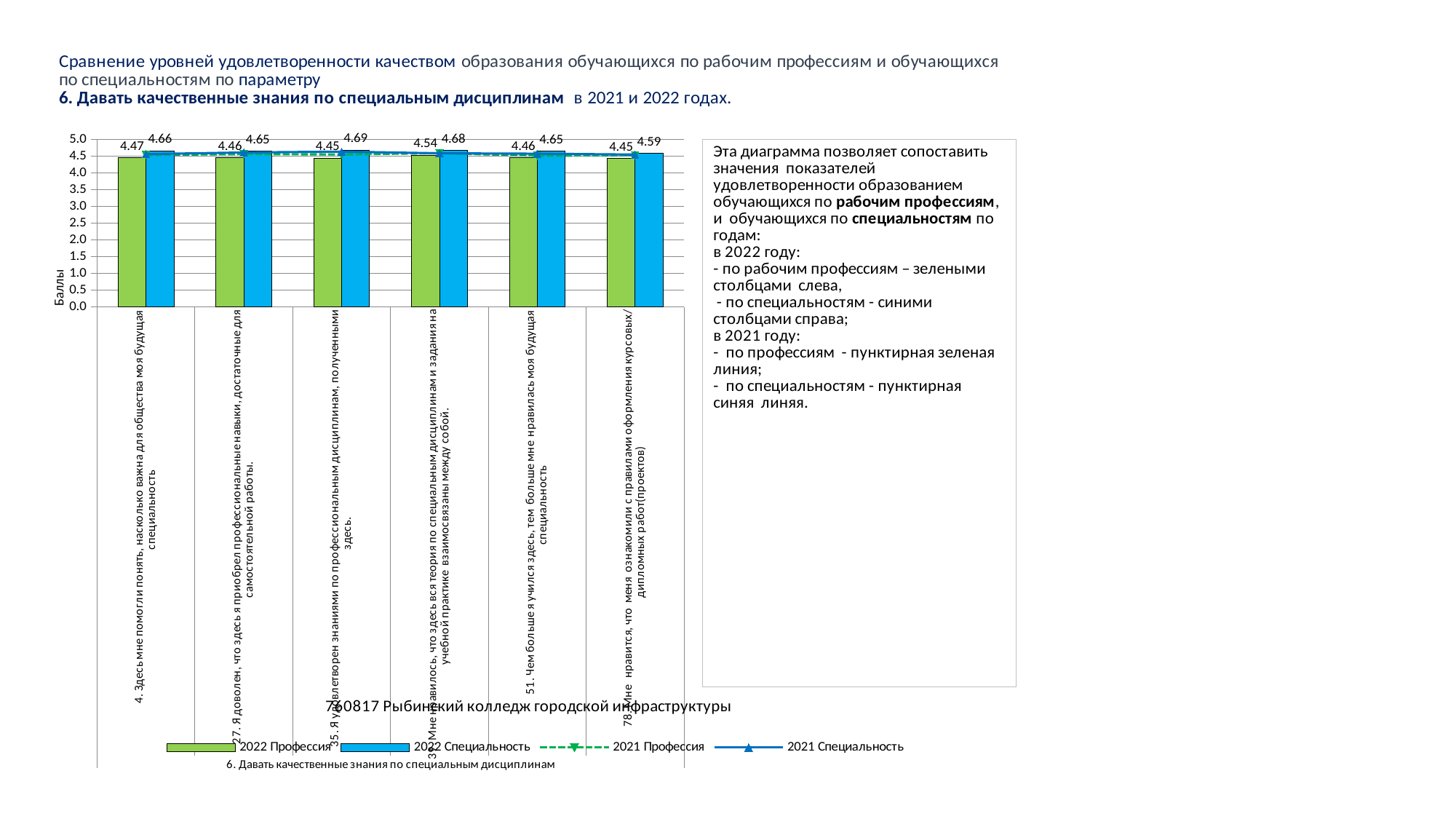
What is the label of the vertical axis of the chart? Баллы Which category has the highest 2022 Специальность value? 35. Я удовлетворен знаниями по профессиональным дисциплинам, полученными здесь How many categories are shown on the x axis of the chart? 6 What is the highest value among the 2022 Профессия bars? 4.54 What is the difference between the 2022 Специальность and 2022 Профессия values for category 4? 0.19 For category 51, which is larger: the 2022 Профессия value or the 2022 Специальность value? 2022 Специальность What is the value of the 2022 Профессия bar for category 4 ("Здесь мне помогли понять, насколько важна для общества моя будущая специальность")? 4.47 What is the value of the 2022 Специальность bar for category 78 ("Мне нравится, что меня ознакомили с правилами оформления курсовых/дипломных работ")? 4.59 How many series does the chart legend list? 4 Which category has the lowest 2022 Специальность value? 78. Мне нравится, что меня ознакомили с правилами оформления курсовых/дипломных работ(проектов) What is the difference between the 2022 Специальность and 2022 Профессия values for category 78? 0.14 What is the value of the 2022 Специальность bar for category 35 ("Я удовлетворен знаниями по профессиональным дисциплинам, полученными здесь")? 4.69